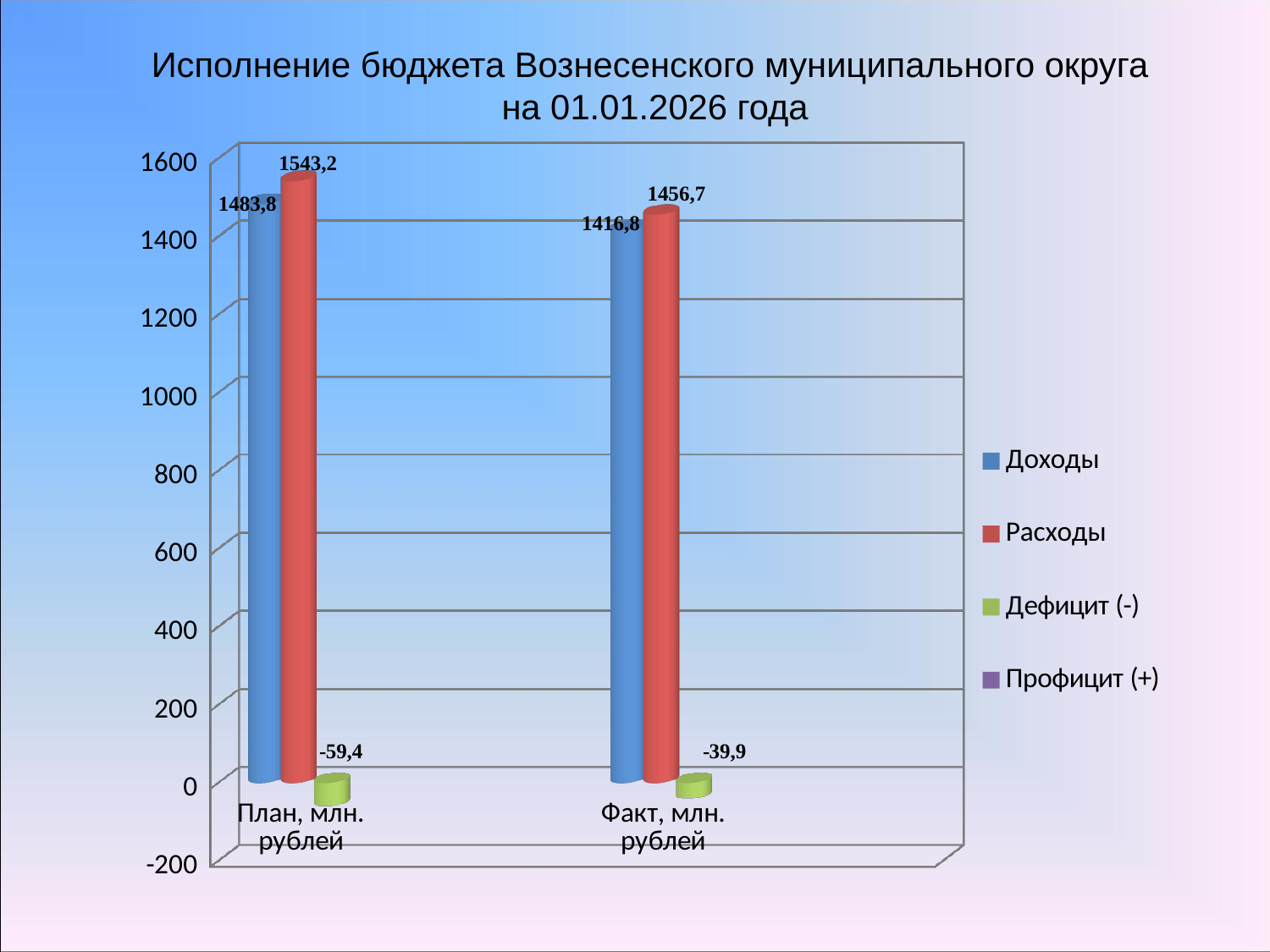
What is the value of Расходы for Факт, млн. рублей? 1456,7 Is the value of Доходы for Факт, млн. рублей greater or less than 1400? greater What kind of chart is shown on the slide? Bar chart How many categories are shown on the x axis? 2 What is the difference between Доходы for План, млн. рублей and Доходы for Факт, млн. рублей? 67 What is the difference between Расходы and Доходы for План, млн. рублей? 59,4 What is the value of Дефицит (-) for Факт, млн. рублей? -39,9 What is the value of Доходы for План, млн. рублей? 1483,8 How many series does the legend list? 4 What colour represents Расходы in the legend? Red Which category has the higher value for Расходы: План, млн. рублей or Факт, млн. рублей? План, млн. рублей What is the value of Дефицит (-) for План, млн. рублей? -59,4